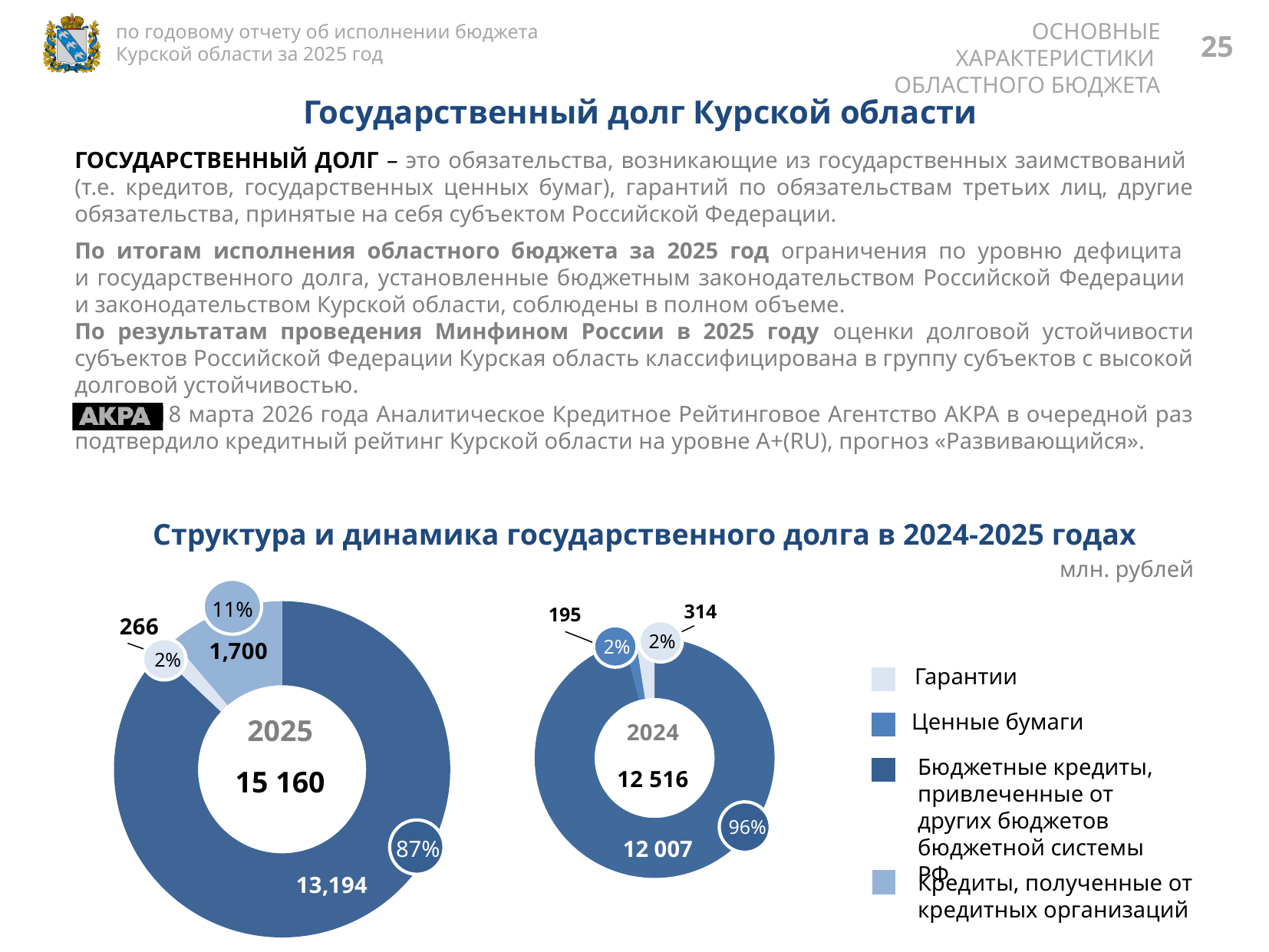
On the 2025 donut chart, what share of the debt is credits received from credit organizations? 11% On the 2024 donut chart, what is the value of guarantees (Гарантии)? 314 How many categories does the legend list for the donut charts? 4 On the 2024 donut chart, what share of the debt is budget credits? 96% What is the total state debt shown in the centre of the 2025 donut chart? 15 160 By how much did budget credits increase from the 2024 chart (12 007) to the 2025 chart (13,194)? 1,187 On the 2025 donut chart, which category has the largest value? Бюджетные кредиты, привлеченные от других бюджетов бюджетной системы РФ On the 2024 donut chart, what is the value of securities (Ценные бумаги)? 195 What type of chart is used to show the structure of state debt in 2024 and 2025? Donut (pie) chart On the 2025 donut chart, what is the value of budget credits attracted from other budgets of the budget system of the Russian Federation? 13,194 On the 2025 donut chart, what is the value of credits received from credit organizations? 1,700 What is the total state debt shown in the centre of the 2024 donut chart? 12 516